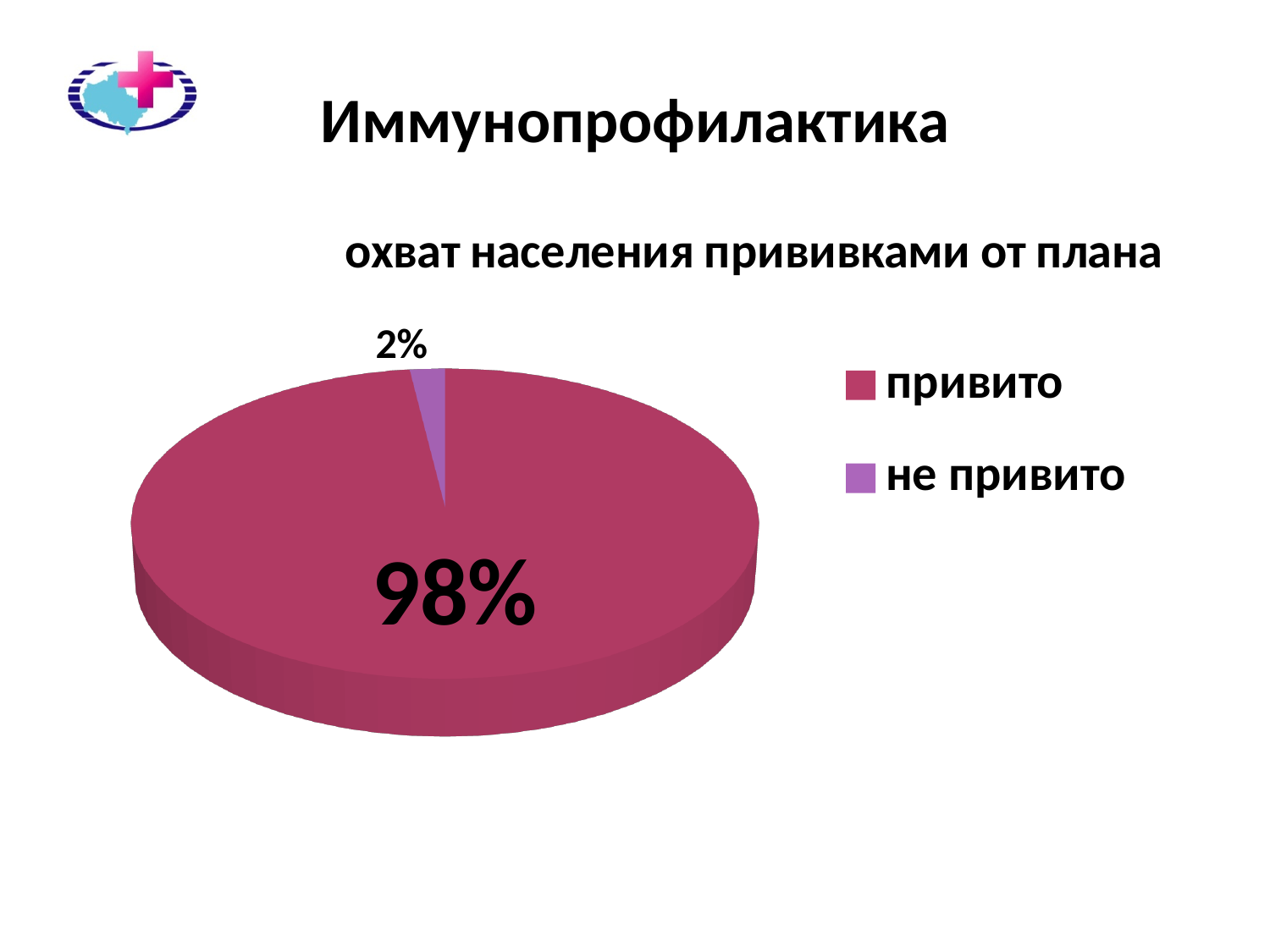
How many entries does the legend list? 2 What is the title of the chart? охват населения прививками от плана What is the value for "привито"? 98% What is the difference between the shares for "привито" and "не привито"? 96% What share of the pie does "привито" take? 98% Which category has the smallest share of the pie? не привито Which is larger, the share for "привито" or for "не привито"? привито What kind of chart is shown on the slide? pie chart How many slices does the pie chart have? 2 What colour is the slice for "не привито"? purple What is the value for "не привито"? 2% Which category has the largest share of the pie? привито